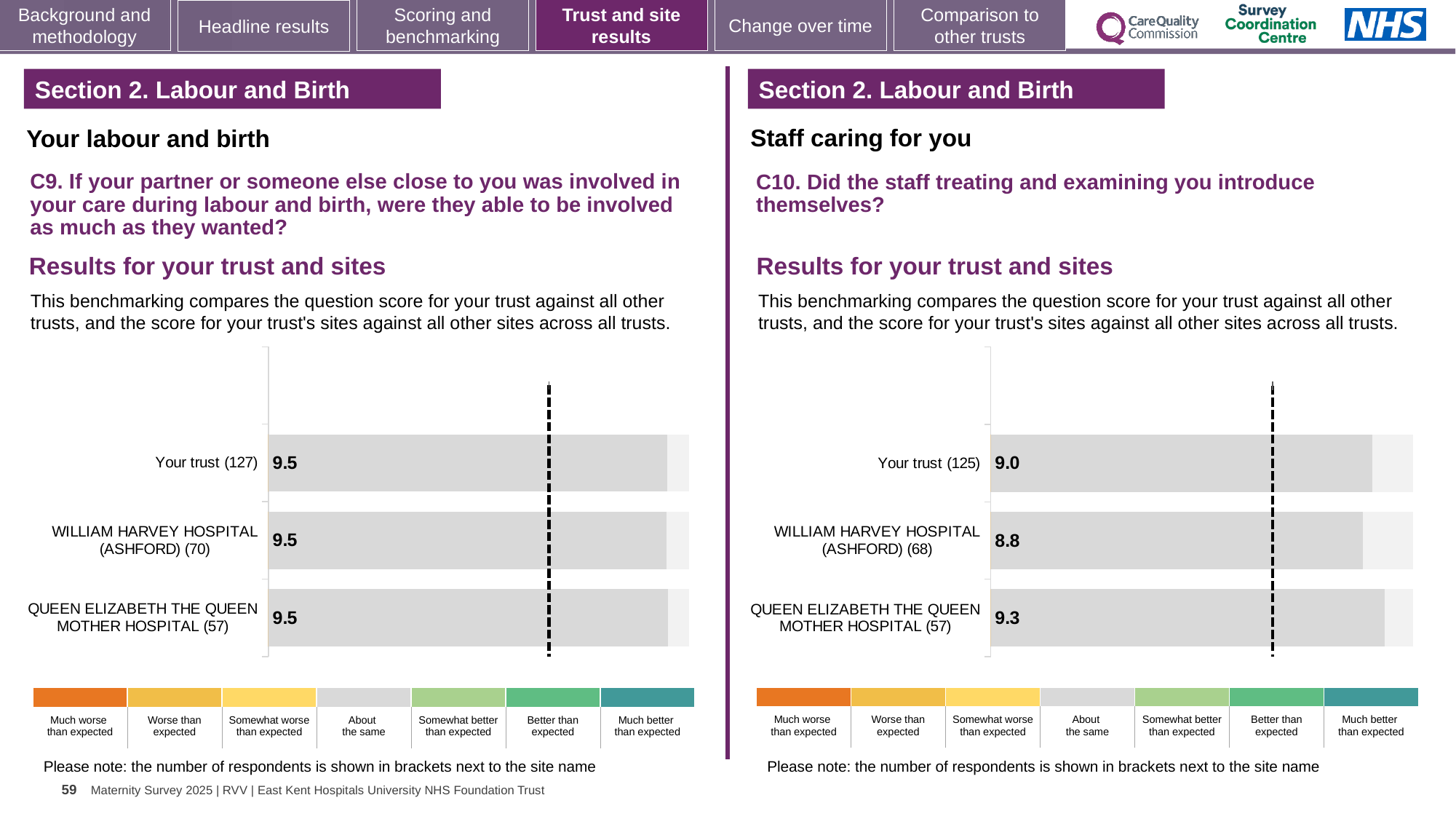
In the C10 chart on the right, which site or trust has the highest score? QUEEN ELIZABETH THE QUEEN MOTHER HOSPITAL (57) In the C10 chart on the right, which has the larger score: Your trust (125) or QUEEN ELIZABETH THE QUEEN MOTHER HOSPITAL (57)? QUEEN ELIZABETH THE QUEEN MOTHER HOSPITAL (57) In the C10 chart on the right, which site or trust has the lowest score? WILLIAM HARVEY HOSPITAL (ASHFORD) (68) How many bars are shown in the C9 chart on the left? 3 In the C9 chart on the left, what is the score for Your trust (127)? 9.5 In the C9 chart on the left, what is the score for WILLIAM HARVEY HOSPITAL (ASHFORD) (70)? 9.5 In the C10 chart on the right, what is the difference between the scores for QUEEN ELIZABETH THE QUEEN MOTHER HOSPITAL (57) and WILLIAM HARVEY HOSPITAL (ASHFORD) (68)? 0.5 In the C10 chart on the right, what is the score for Your trust (125)? 9.0 How many respondents are shown in brackets for Your trust in the C9 chart on the left? 127 What type of chart is used in the C10 chart on the right? Bar chart In the C10 chart on the right, what is the score for QUEEN ELIZABETH THE QUEEN MOTHER HOSPITAL (57)? 9.3 In the C10 chart on the right, what is the score for WILLIAM HARVEY HOSPITAL (ASHFORD) (68)? 8.8